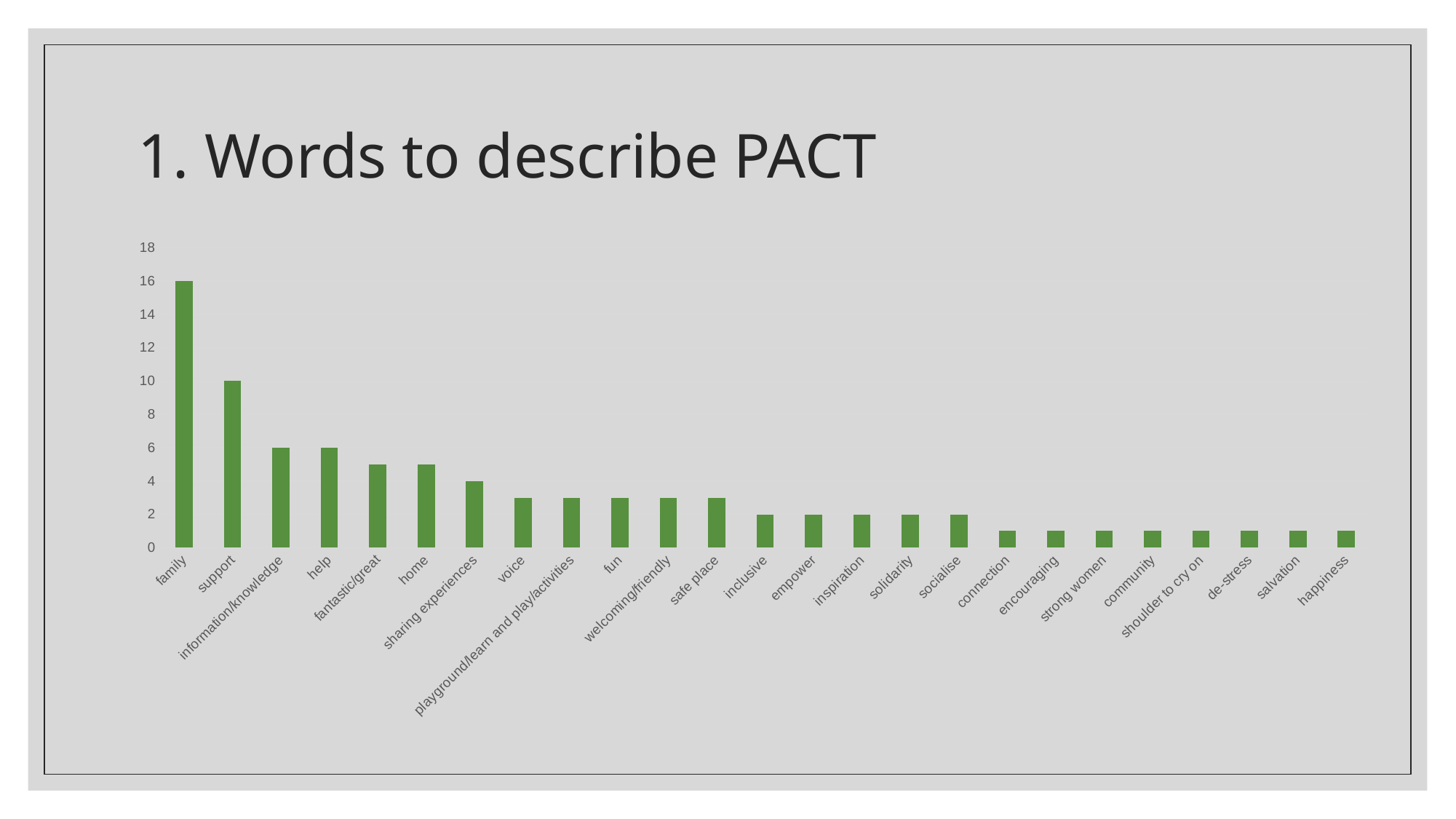
Which has a larger value, support or help? support Is the value for fantastic/great greater or less than 4? greater What is the value for sharing experiences? 4 What is the value for information/knowledge? 6 Which word has the highest count in the chart? family What is the value for support? 10 How many words (categories) are shown on the x axis? 25 What is the value for family? 16 What is the difference between the values for family and support? 6 What is the title of the slide containing the chart? 1. Words to describe PACT What type of chart is shown on the slide? bar chart Do the values generally rise or fall moving from left to right along the x axis? fall